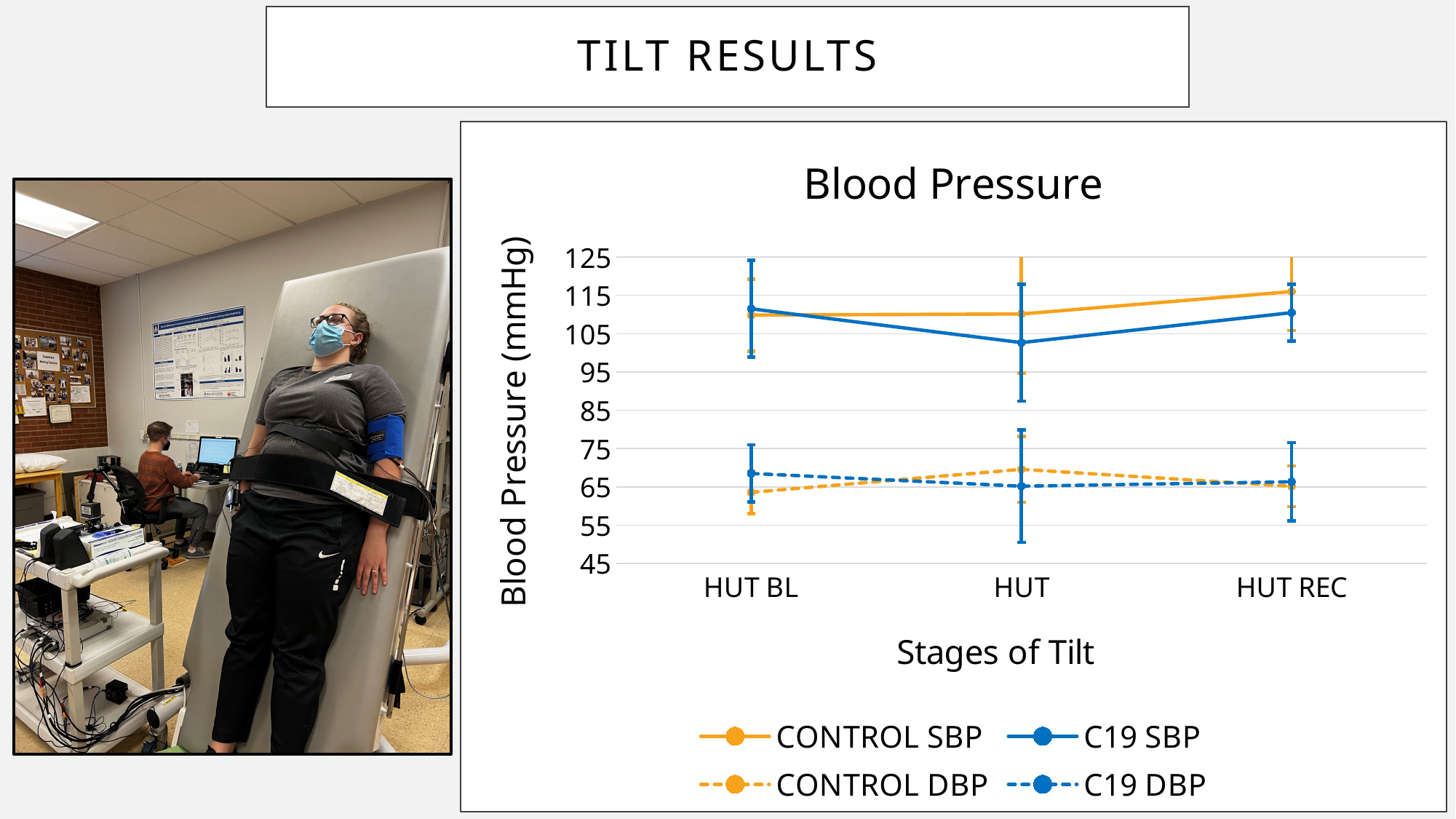
At which stage of tilt is C19 SBP lowest? HUT How many series does the legend of the Blood Pressure chart list? 4 Is the CONTROL DBP value at HUT BL greater or less than 75? less At the HUT stage, which is larger: CONTROL SBP or C19 SBP? CONTROL SBP At the HUT stage, which is larger: CONTROL DBP or C19 DBP? CONTROL DBP What is the y-axis label of the Blood Pressure chart? Blood Pressure (mmHg) At which stage of tilt is CONTROL SBP highest? HUT REC Is the C19 SBP value at HUT greater or less than 95? greater What type of chart is shown under the title "Blood Pressure"? line chart Does C19 SBP rise or fall from HUT BL to HUT? fall Which series in the Blood Pressure chart is drawn as a solid blue line? C19 SBP How many stages of tilt are shown on the x axis of the Blood Pressure chart? 3